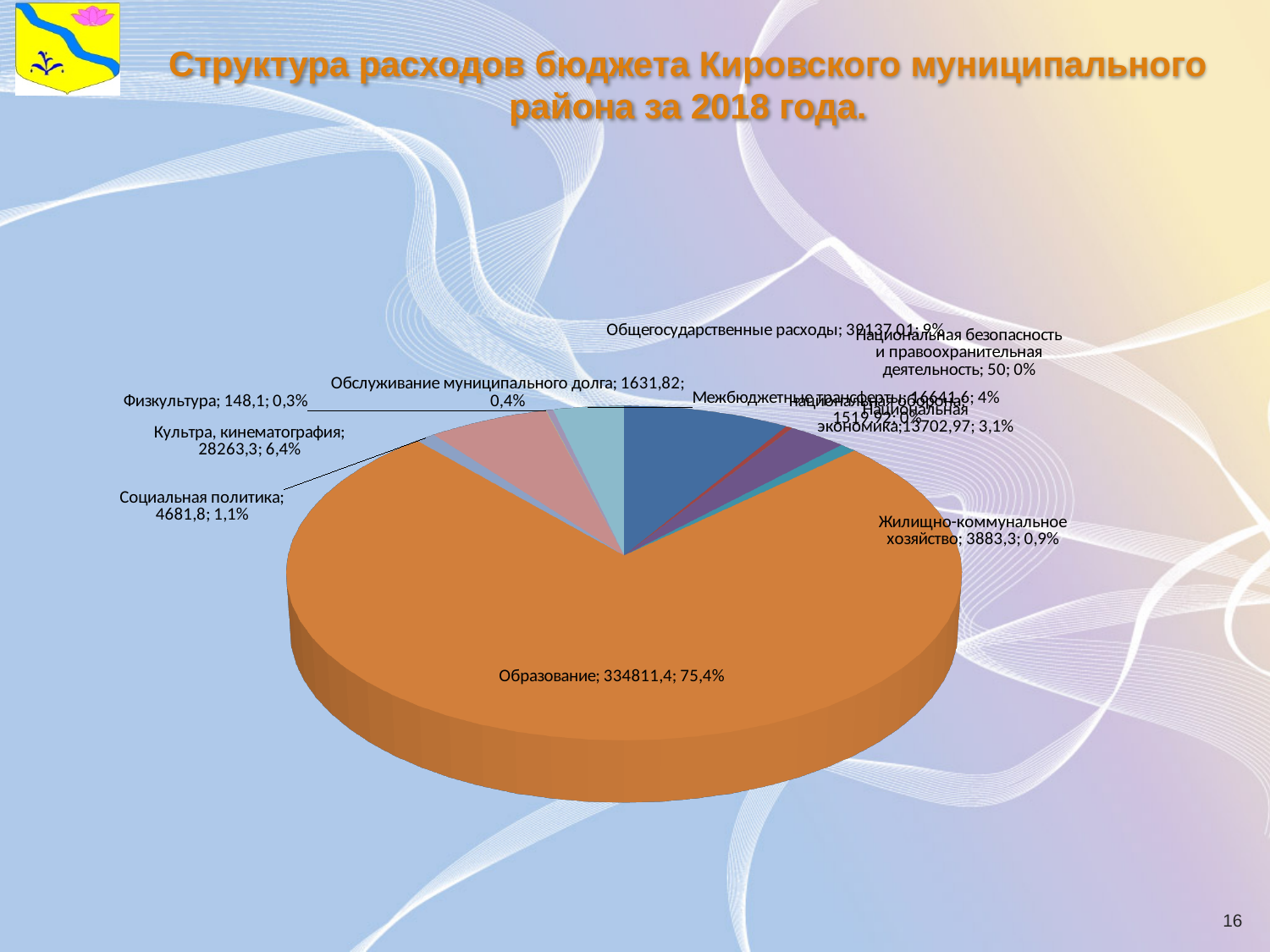
What is the value shown for Социальная политика? 4681,8 Which is larger, the value for Физкультура or the value for Обслуживание муниципального долга? Обслуживание муниципального долга What share of expenditures does Национальная экономика account for? 3,1% What is the value shown for Жилищно-коммунальное хозяйство? 3883,3 What share of expenditures does Культра, кинематография account for? 6,4% What kind of chart is shown on the slide? Pie chart What is the difference between the values for Культра, кинематография and Социальная политика? 23581,5 What is the value shown for Культра, кинематография? 28263,3 What share of expenditures does Образование account for? 75,4% What is the value shown for Образование? 334811,4 Which category has the largest share of the budget expenditures? Образование What is the title of the chart on the slide? Структура расходов бюджета Кировского муниципального района за 2018 года.